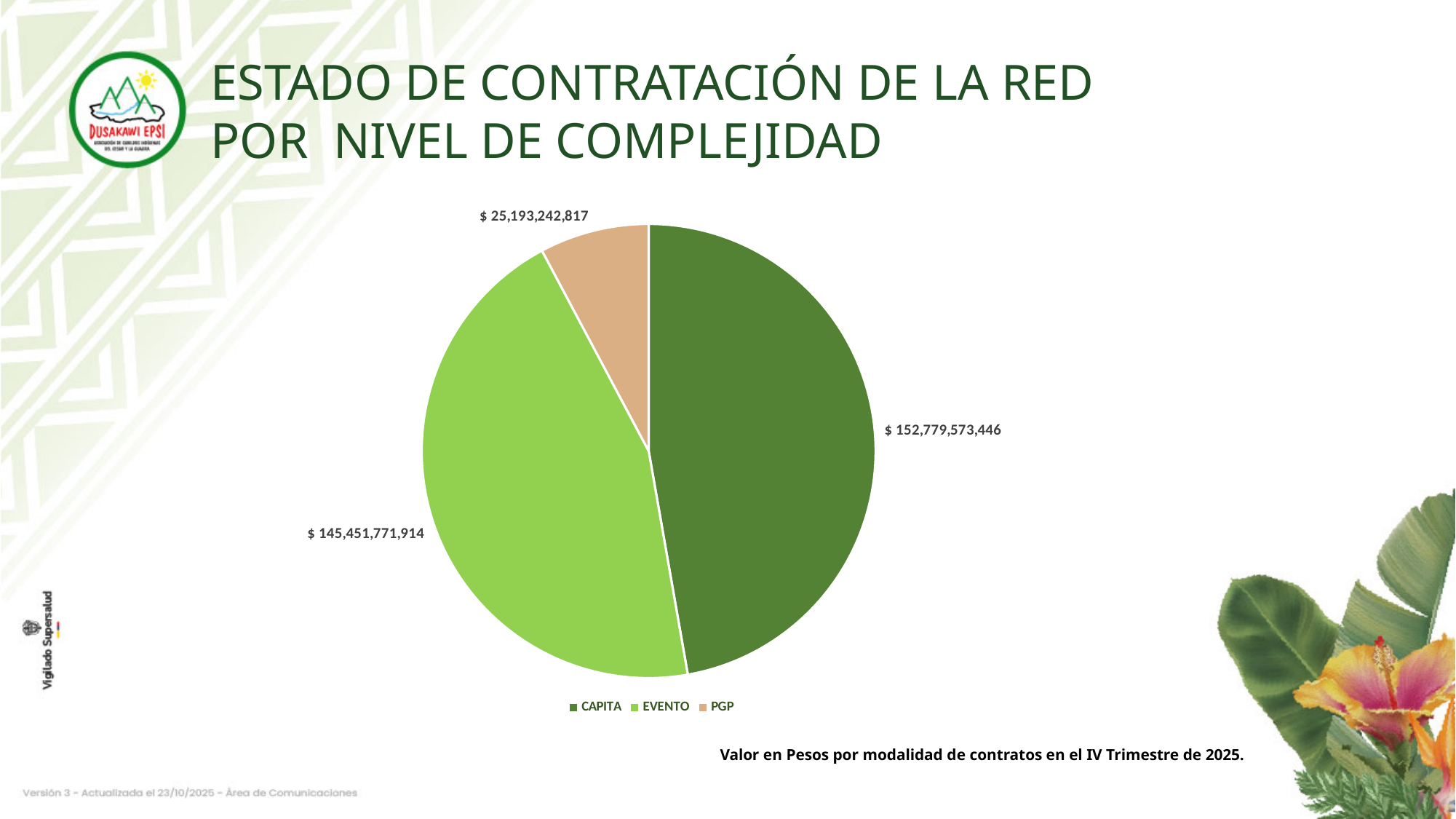
What is the value for PGP? $ 25,193,242,817 What colour is the PGP slice? tan (light brown) Which is larger, the value for CAPITA or the value for EVENTO? CAPITA What type of chart is shown on the slide? pie chart What is the value for EVENTO? $ 145,451,771,914 Which category has the largest value? CAPITA What is the difference between the values for EVENTO and PGP? $ 120,258,529,097 What is the value for CAPITA? $ 152,779,573,446 What are the legend entries of the pie chart? CAPITA, EVENTO, PGP What is the difference between the values for CAPITA and EVENTO? $ 7,327,801,532 How many categories does the pie chart show? 3 Which category has the smallest slice of the pie? PGP